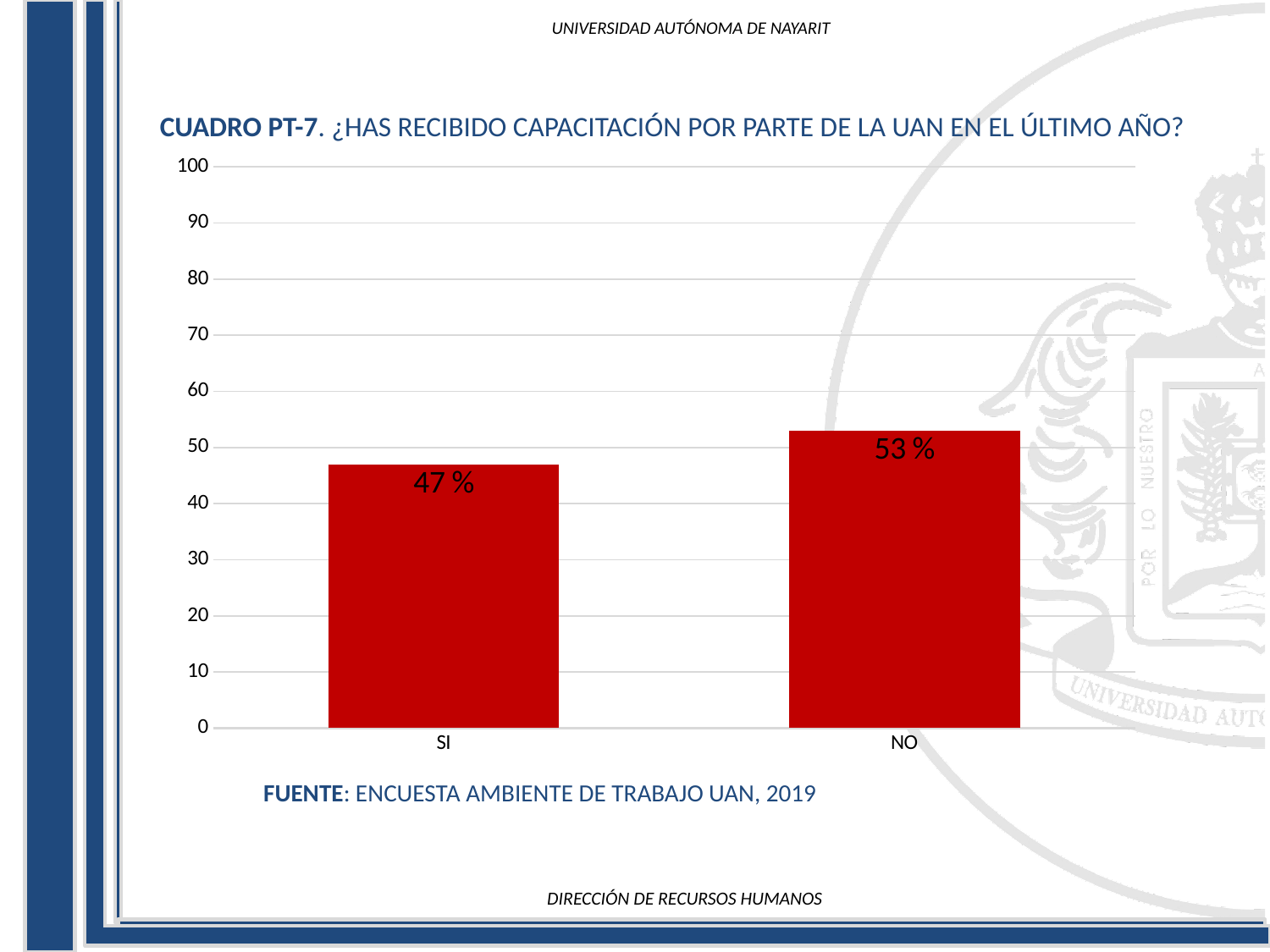
What is the difference between the values for NO and SI? 6 % Is the value for NO greater or less than 50? greater Which category has the highest value? NO What is the value for NO? 53 % Which category has the lowest value? SI What is the maximum value shown on the y axis? 100 What kind of chart is shown on the slide? bar chart How many categories are shown on the x axis? 2 Which is larger, the value for SI or the value for NO? NO What is the value for SI? 47 % What source is cited below the chart? ENCUESTA AMBIENTE DE TRABAJO UAN, 2019 Is the value for SI greater or less than 50? less